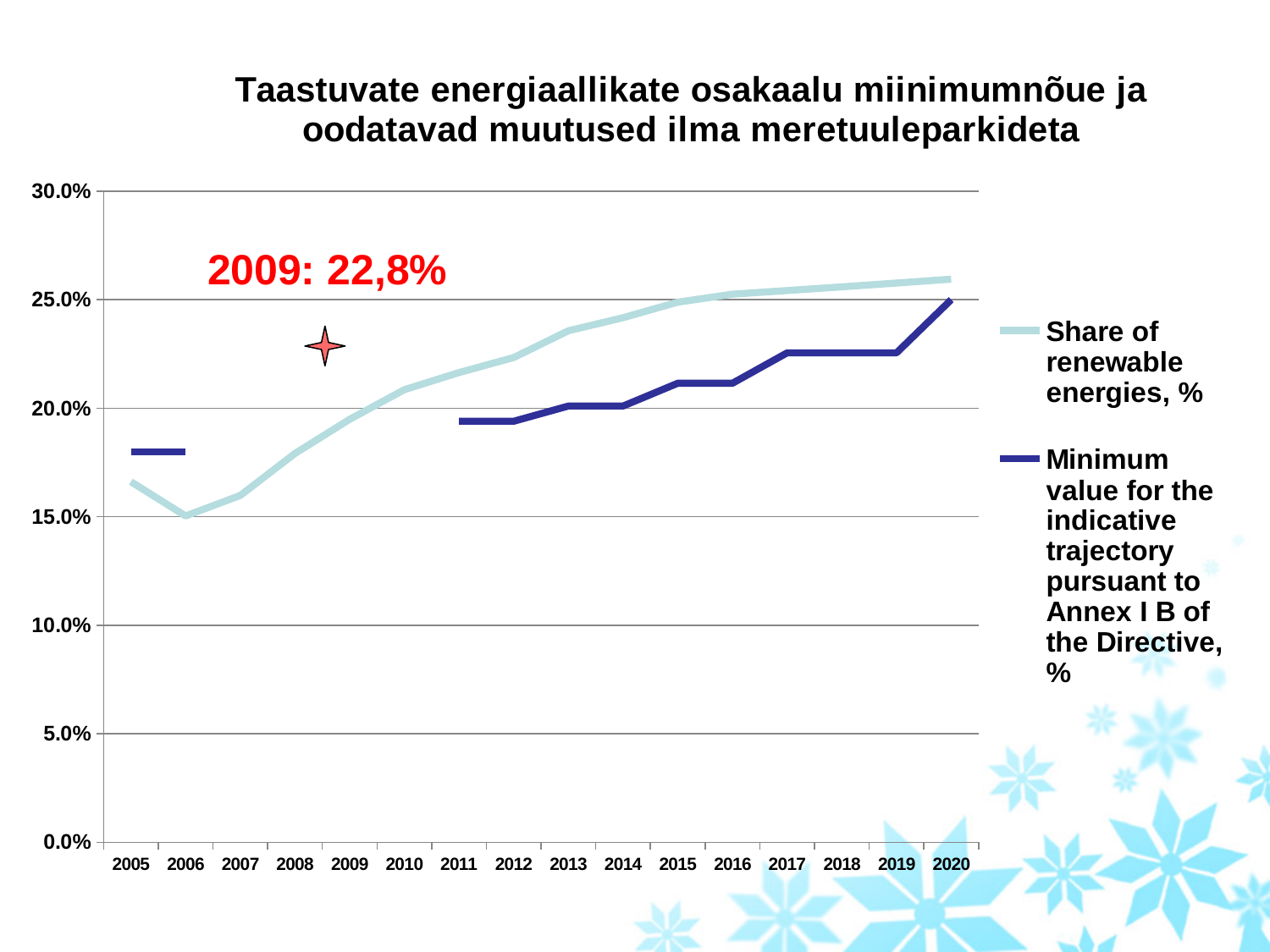
What kind of chart is shown on the slide? line chart In which year is the Share of renewable energies lowest? 2006 Is the Share of renewable energies in 2006 greater or less than 20.0%? less In 2015, which series is higher: Share of renewable energies or Minimum value for the indicative trajectory? Share of renewable energies Is the Minimum value for the indicative trajectory in 2005 greater or less than 20.0%? less Does the Share of renewable energies rise or fall from 2010 to 2020? rise How many series does the legend list? 2 Is the Share of renewable energies in 2020 greater or less than 25.0%? greater In which year is the Share of renewable energies highest? 2020 What value does the red annotation give for 2009? 22,8% How many years are shown on the x axis? 16 What is the first legend entry of the chart? Share of renewable energies, %